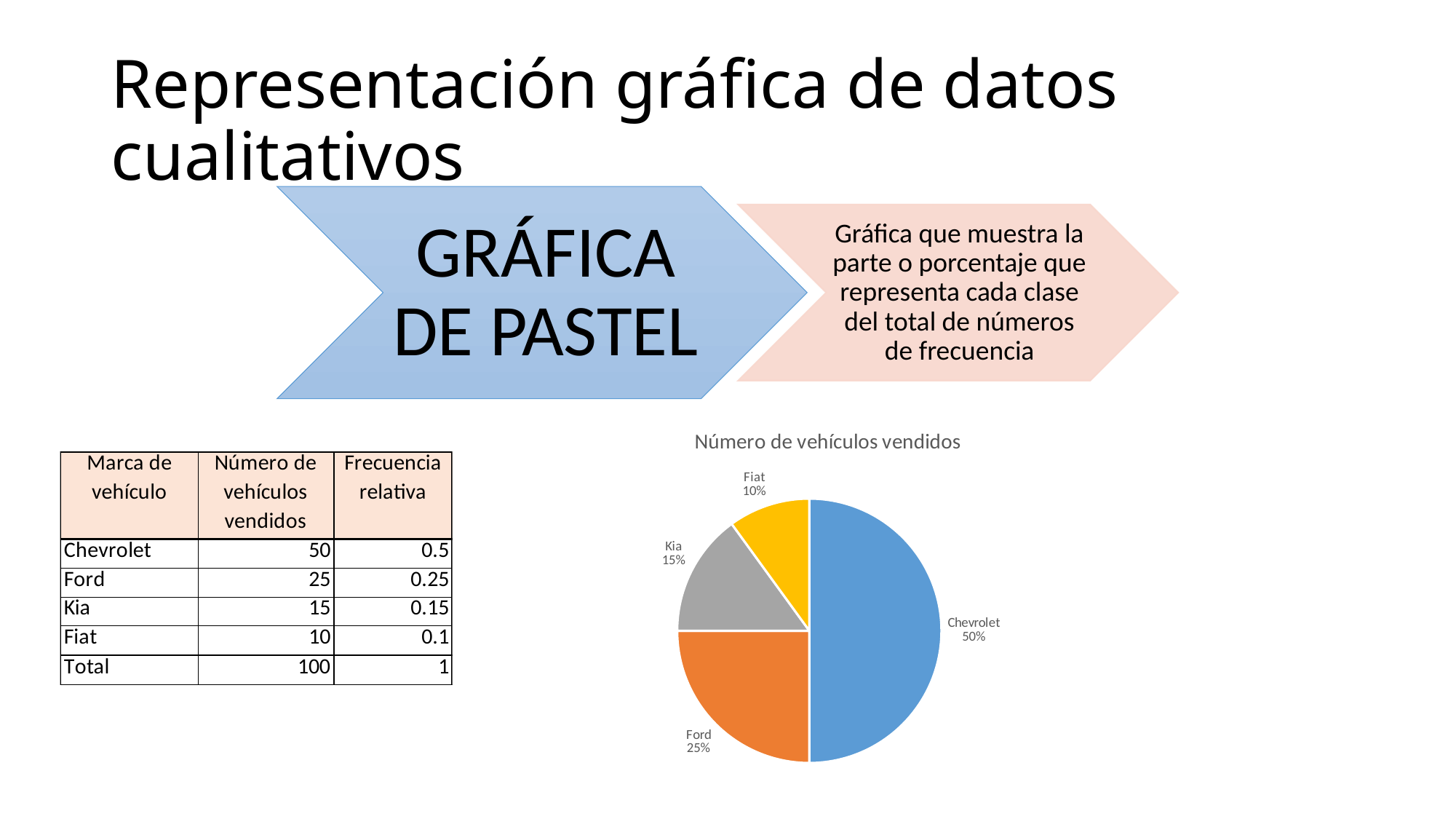
What share of the pie does Fiat represent? 10% Which slice is larger, Kia or Fiat? Kia What is the title of the chart? Número de vehículos vendidos What colour is the Ford slice in the pie chart? orange What is the difference in percentage points between the Chevrolet and Ford slices? 25% How many slices does the pie chart have? 4 Which brand has the smallest slice of the pie? Fiat What share of the pie does Chevrolet represent? 50% What type of chart is shown on the slide? pie chart What share of the pie does Kia represent? 15% Which brand has the largest slice of the pie? Chevrolet